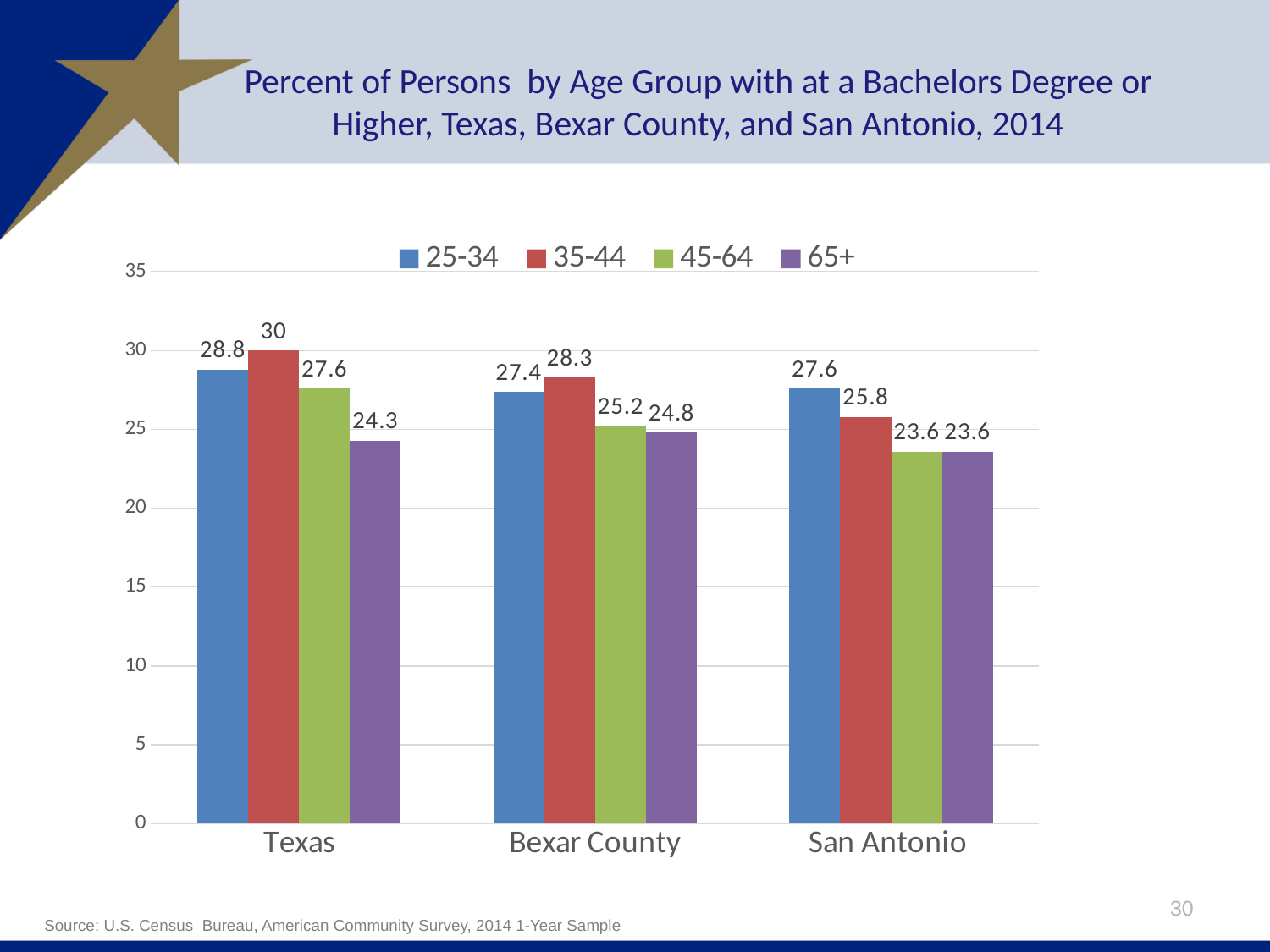
What is the value for the 35-44 age group in Texas? 30 What kind of chart is shown on the slide? bar chart Which age group has the lowest value in Texas? 65+ How many series does the legend list? 4 Is the value for the 45-64 age group in San Antonio greater or less than 25? less What is the difference between the 35-44 and 65+ values in Texas? 5.7 What is the value for the 25-34 age group in San Antonio? 27.6 How many geographic categories are shown on the x axis? 3 Which is larger, the 25-34 value for Bexar County or the 25-34 value for San Antonio? San Antonio What is the value for the 65+ age group in Bexar County? 24.8 Which age group is represented by the green bars? 45-64 Which age group has the highest value in Bexar County? 35-44